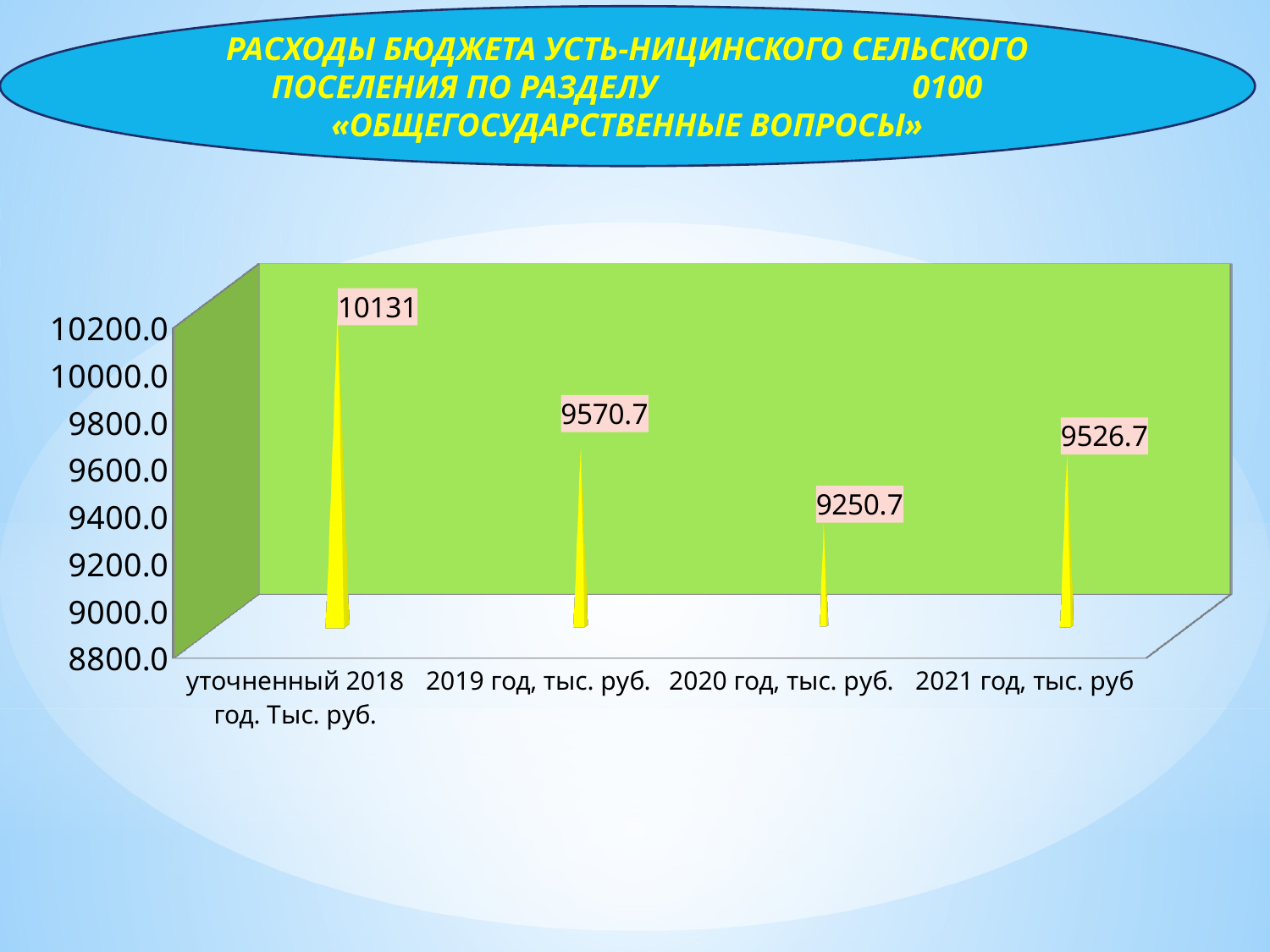
Which category has the highest value? уточненный 2018 год. Тыс. руб. What kind of chart is shown on the slide? bar chart What is the difference between the values for уточненный 2018 год and 2019 год? 560.3 What is the difference between the values for 2019 год and 2020 год? 320.0 What is the value for уточненный 2018 год. Тыс. руб.? 10131 What is the value for 2019 год, тыс. руб.? 9570.7 What is the value for 2021 год, тыс. руб? 9526.7 How many categories are shown on the x axis? 4 What is the value for 2020 год, тыс. руб.? 9250.7 Is the value for 2020 год, тыс. руб. greater or less than 9400? less Which category has the lowest value? 2020 год, тыс. руб. Which is larger, the value for 2019 год or the value for 2021 год? 2019 год, тыс. руб.